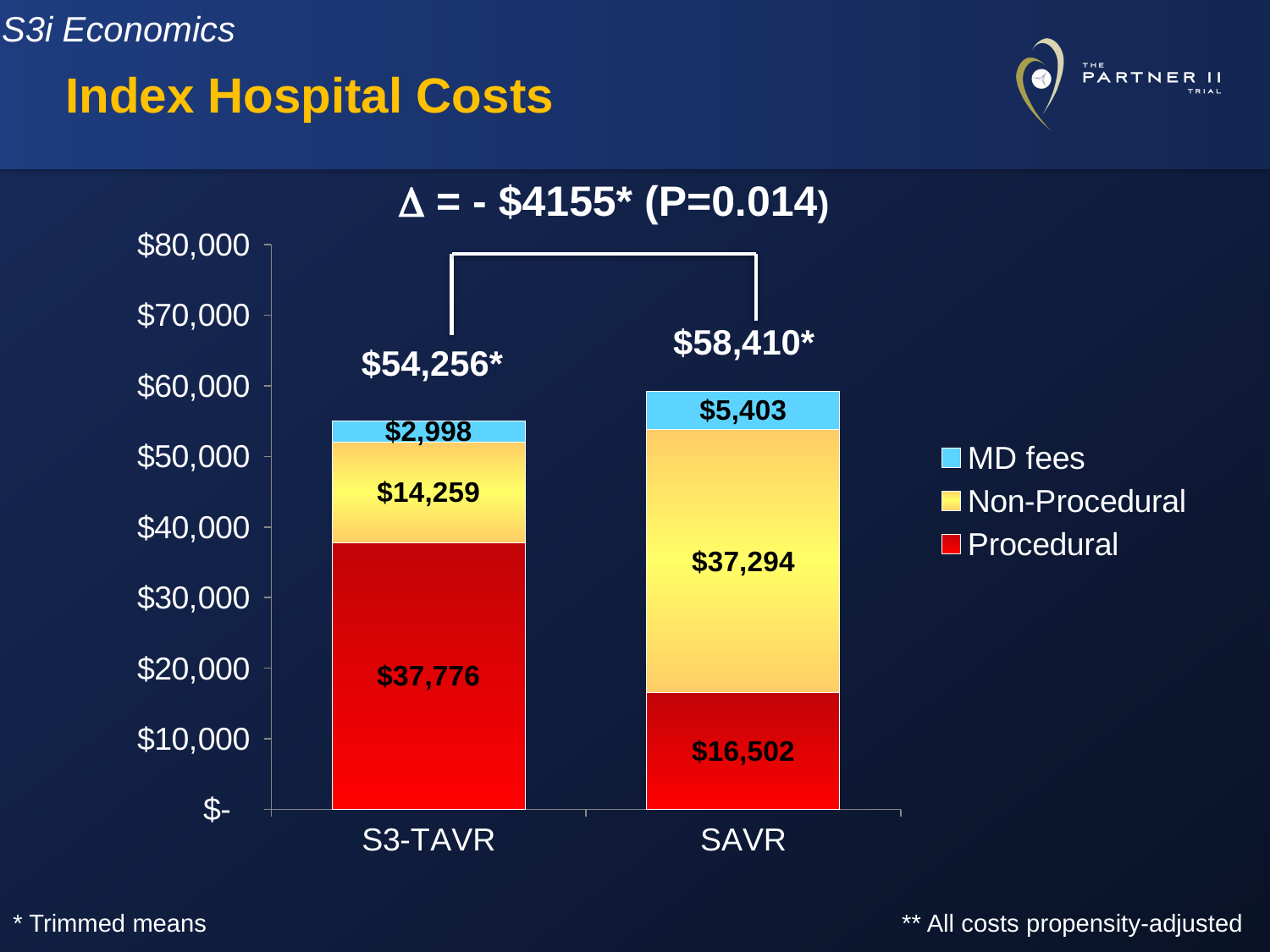
What is the MD fees value for S3-TAVR? $2,998 Which category has the higher Procedural cost, S3-TAVR or SAVR? S3-TAVR How many series does the legend list? 3 What is the difference in Procedural cost between S3-TAVR and SAVR? $21,274 What is the difference in MD fees between SAVR and S3-TAVR? $2,405 What is the total index hospital cost labelled above the SAVR bar? $58,410* What is the MD fees value for SAVR? $5,403 What type of chart is shown on the slide? Stacked bar chart What is the total index hospital cost labelled above the S3-TAVR bar? $54,256* Which legend entry is shown in red? Procedural What is the Non-Procedural cost for SAVR? $37,294 What is the Procedural cost for S3-TAVR? $37,776